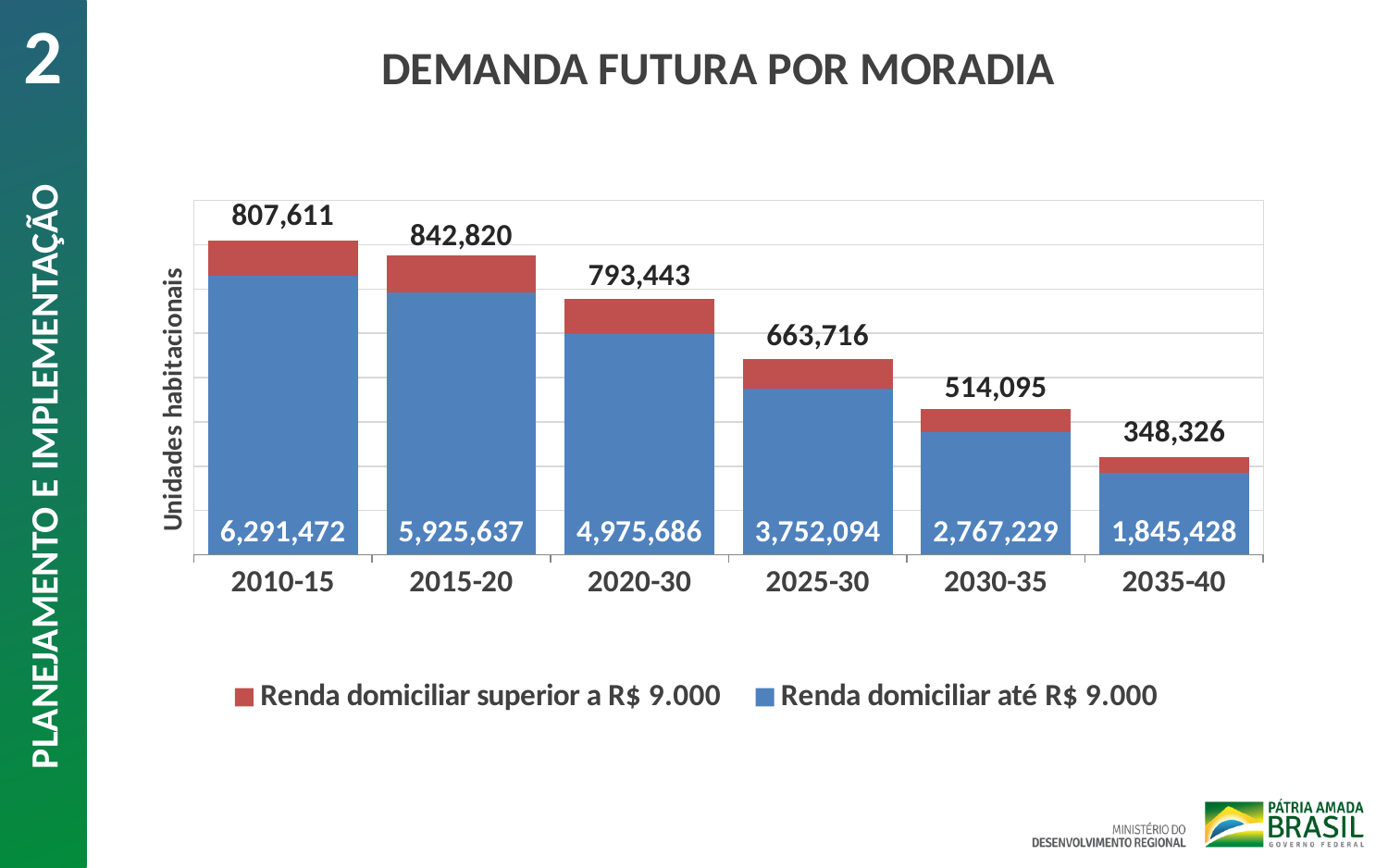
What is the difference between the 'Renda domiciliar até R$ 9.000' values for 2010-15 and 2015-20? 365,835 How many series does the legend list? 2 Do the 'Renda domiciliar até R$ 9.000' values rise or fall from 2010-15 to 2035-40? Fall Which is larger: the 'Renda domiciliar superior a R$ 9.000' value for 2010-15 or for 2015-20? 2015-20 What is the value for 'Renda domiciliar superior a R$ 9.000' in 2025-30? 663,716 How many periods are shown on the x axis? 6 What is the value for 'Renda domiciliar até R$ 9.000' in 2010-15? 6,291,472 What kind of chart is shown on the slide? Stacked bar chart What is the total of the stacked bar for 2035-40? 2,193,754 Which period has the highest value for 'Renda domiciliar superior a R$ 9.000'? 2015-20 What is the value for 'Renda domiciliar até R$ 9.000' in 2035-40? 1,845,428 Which period has the lowest value for 'Renda domiciliar até R$ 9.000'? 2035-40